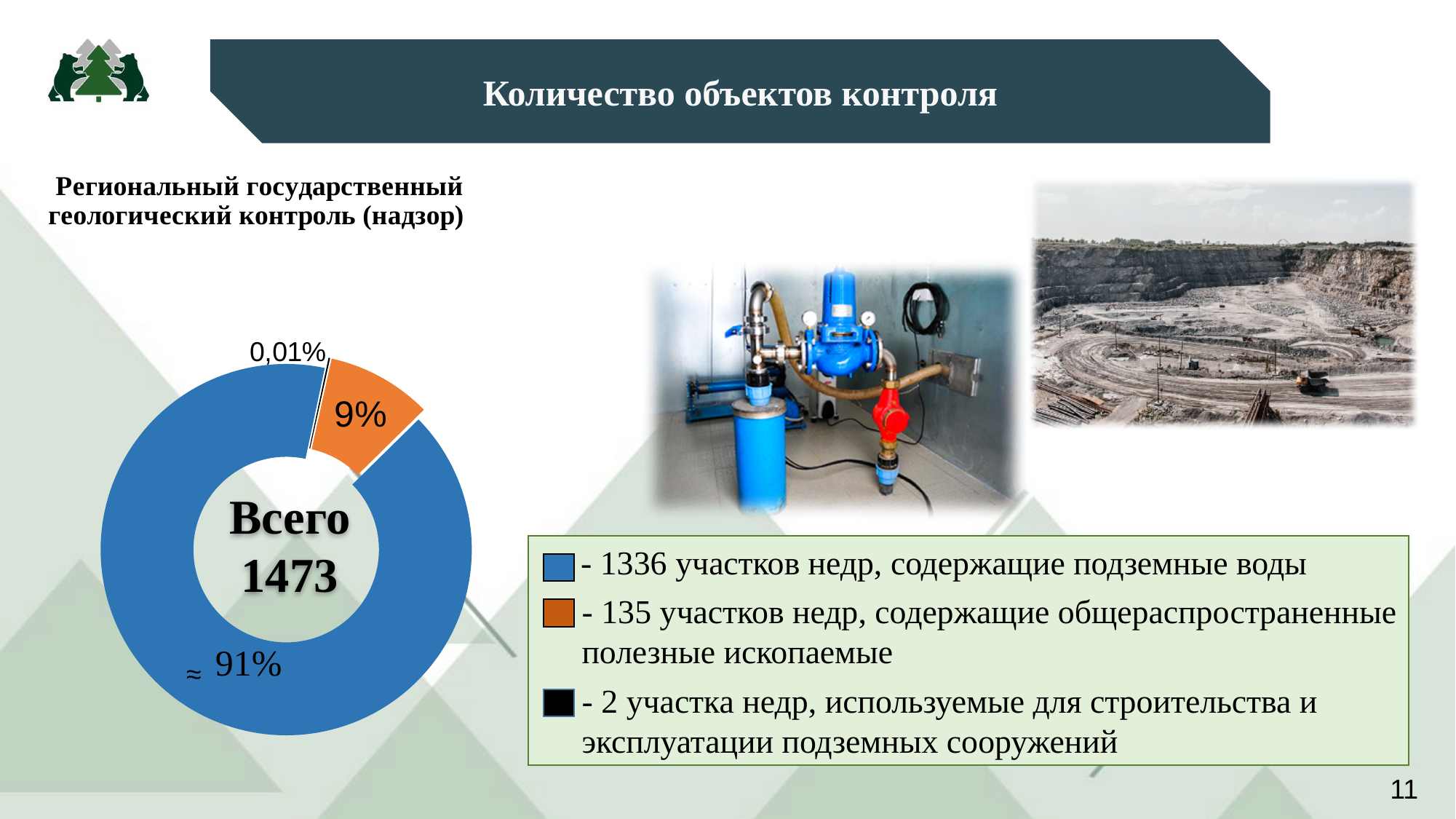
What share of the chart do участки недр, содержащие общераспространенные полезные ископаемые, make up? 9% What share of the chart do участки недр, содержащие подземные воды, make up? 91% How many участков недр, содержащие общераспространенные полезные ископаемые, are shown? 135 How many categories does the chart show? 3 What kind of chart is shown on the slide? pie chart (donut) What is the total number of objects (Всего) shown in the centre of the chart? 1473 Which category has the smallest number of objects? участки недр, используемые для строительства и эксплуатации подземных сооружений What share of the chart do участки недр для строительства и эксплуатации подземных сооружений make up? 0,01% What is the difference between the number of участков недр с подземными водами and участков недр с общераспространенными полезными ископаемыми? 1201 How many участков недр, используемые для строительства и эксплуатации подземных сооружений, are shown? 2 How many участков недр, содержащие подземные воды, are shown in the chart? 1336 Which category has the largest number of objects? участки недр, содержащие подземные воды